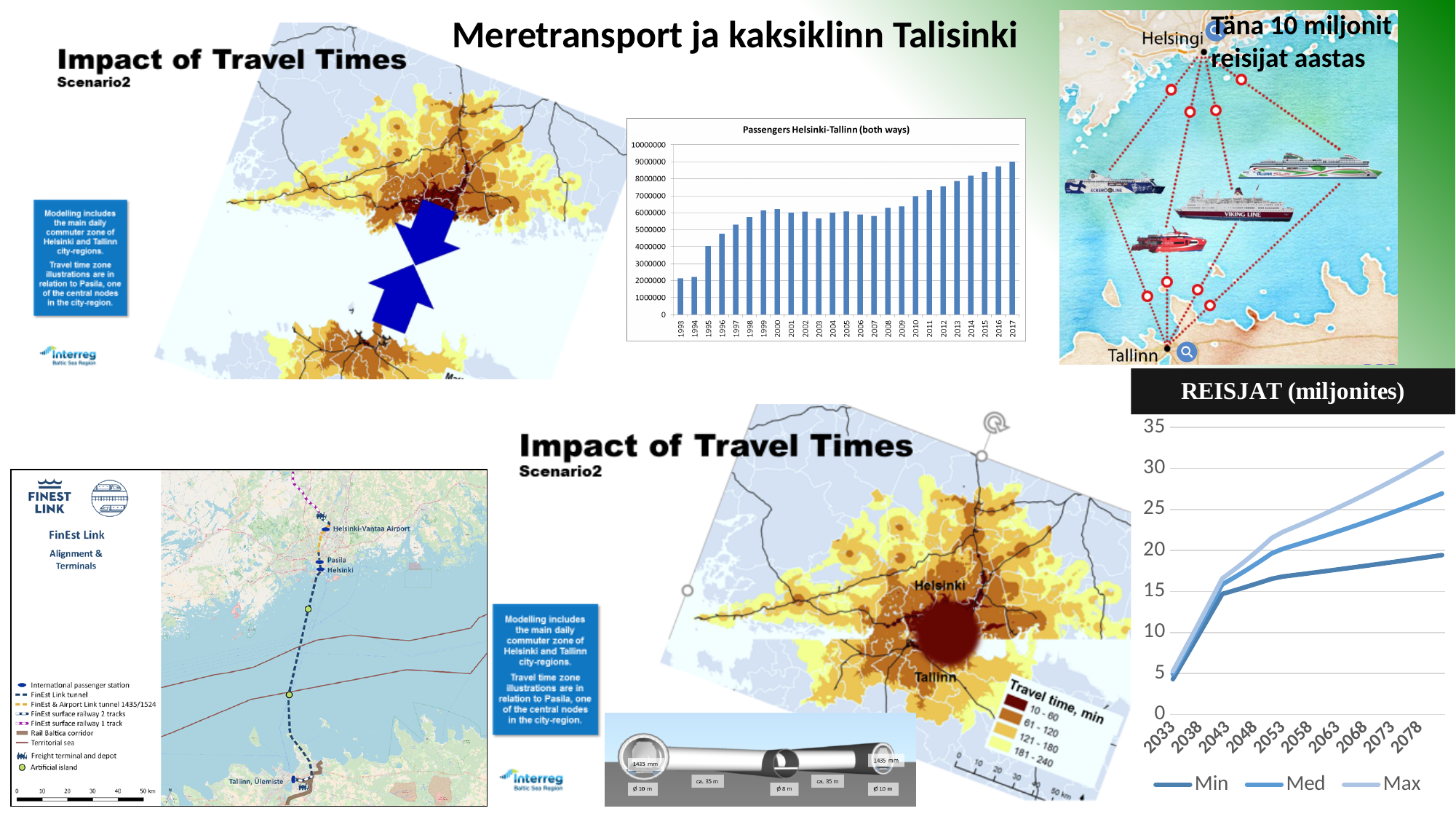
In the 'Passengers Helsinki-Tallinn (both ways)' chart, is the value for 2017 greater or less than 8000000? greater How many series does the legend of the 'REISJAT (miljonites)' chart list? 3 In the 'Passengers Helsinki-Tallinn (both ways)' chart, which is larger, the value for 2015 or the value for 1994? 2015 In the 'Passengers Helsinki-Tallinn (both ways)' chart, is the value for 1993 greater or less than 3000000? less What kind of chart is the 'Passengers Helsinki-Tallinn (both ways)' chart? bar chart In the 'Passengers Helsinki-Tallinn (both ways)' chart, which year has the highest number of passengers? 2017 In the 'Passengers Helsinki-Tallinn (both ways)' chart, is the value for 2000 greater or less than 5000000? greater In the 'REISJAT (miljonites)' chart, do the values of the Min series rise or fall from 2033 to 2078? rise What kind of chart is the 'REISJAT (miljonites)' chart? line chart In the 'Passengers Helsinki-Tallinn (both ways)' chart, which year has the lowest number of passengers? 1993 In the 'Passengers Helsinki-Tallinn (both ways)' chart, how many years are shown on the x axis? 25